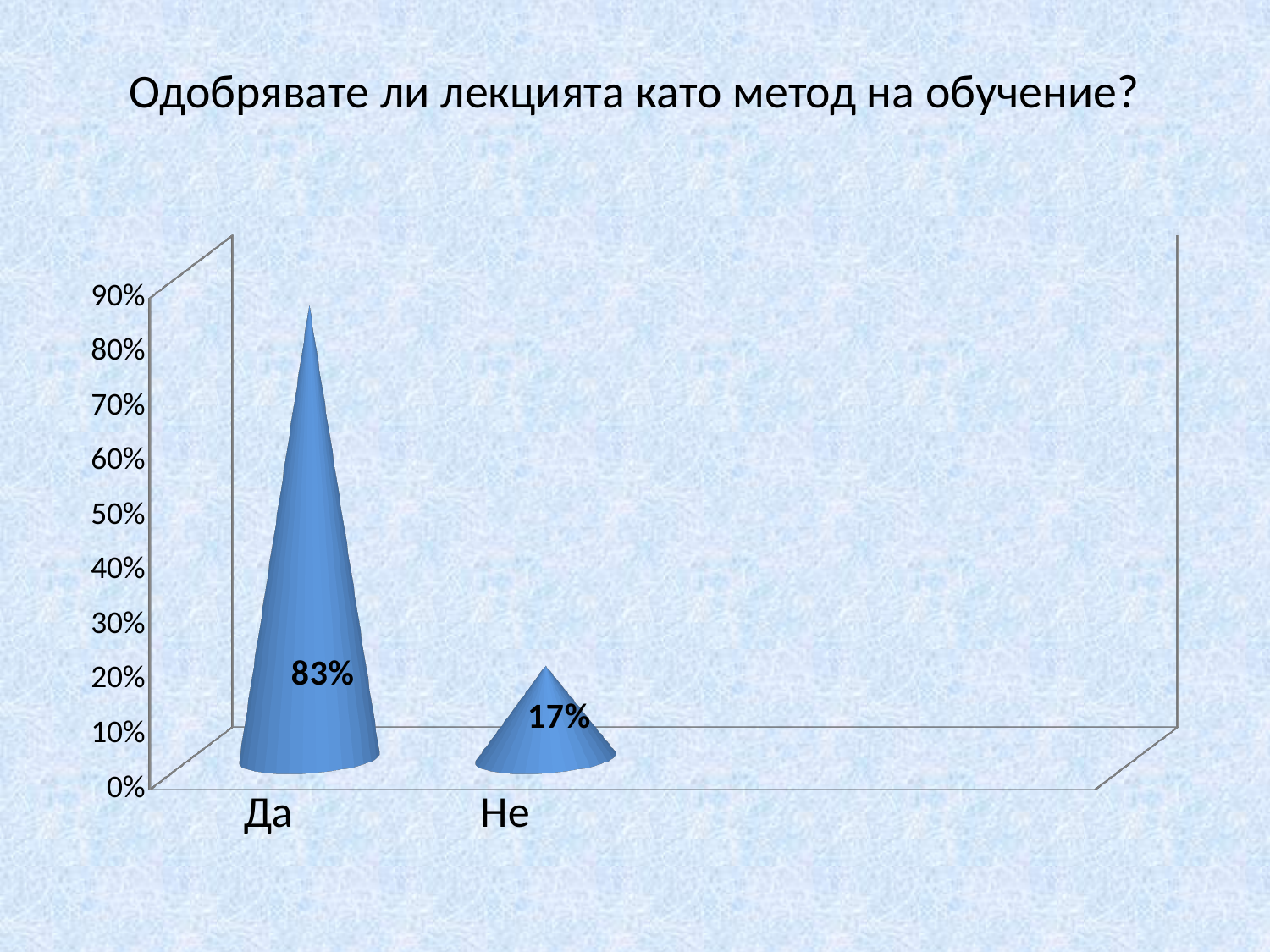
What is the value for Не? 17% What is the difference between the values for Да and Не? 66% What is the value for Да? 83% Is the value for Да greater or less than 50%? greater Is the value for Не greater or less than 30%? less Which is larger, the value for Да or the value for Не? Да Which category has the highest value? Да What kind of chart is shown on the slide? bar chart What is the highest value shown on the vertical axis? 90% What is the title of the slide? Одобрявате ли лекцията като метод на обучение? Which category has the lowest value? Не How many categories are shown on the chart? 2